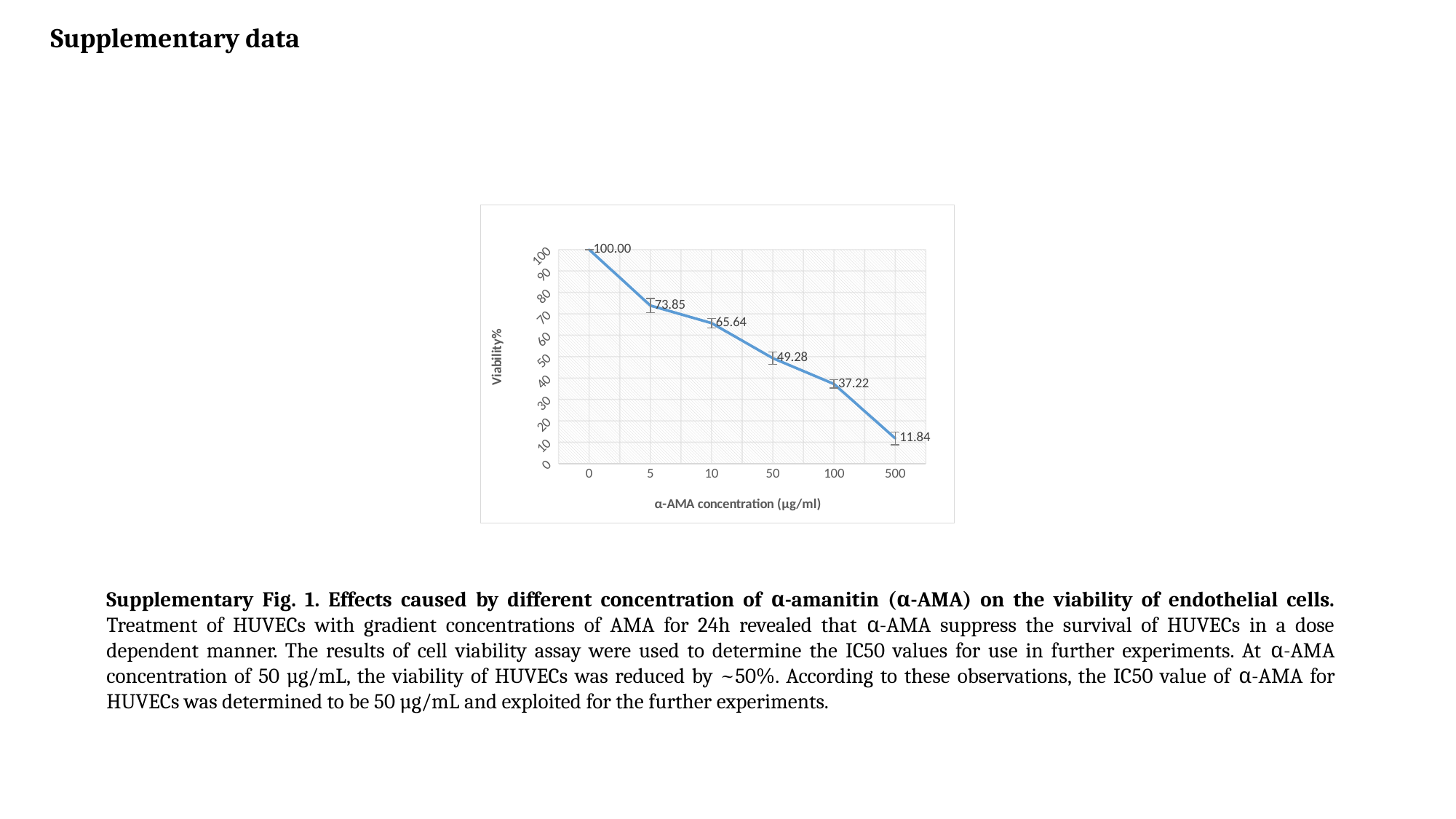
Which has higher viability%: 5 µg/ml or 10 µg/ml? 5 µg/ml Does viability% rise or fall as α-AMA concentration increases along the x axis? Fall What is the viability% at an α-AMA concentration of 5 µg/ml? 73.85 At which α-AMA concentration is viability% highest? 0 What is the label of the x axis of the chart? α-AMA concentration (µg/ml) What kind of chart is shown on the slide? Line chart What is the viability% at an α-AMA concentration of 50 µg/ml? 49.28 What is the viability% at an α-AMA concentration of 0 µg/ml? 100.00 What is the difference in viability% between the 10 µg/ml and 100 µg/ml concentrations? 28.42 What is the viability% at an α-AMA concentration of 500 µg/ml? 11.84 How many concentration points are plotted on the chart? 6 At which α-AMA concentration is viability% lowest? 500